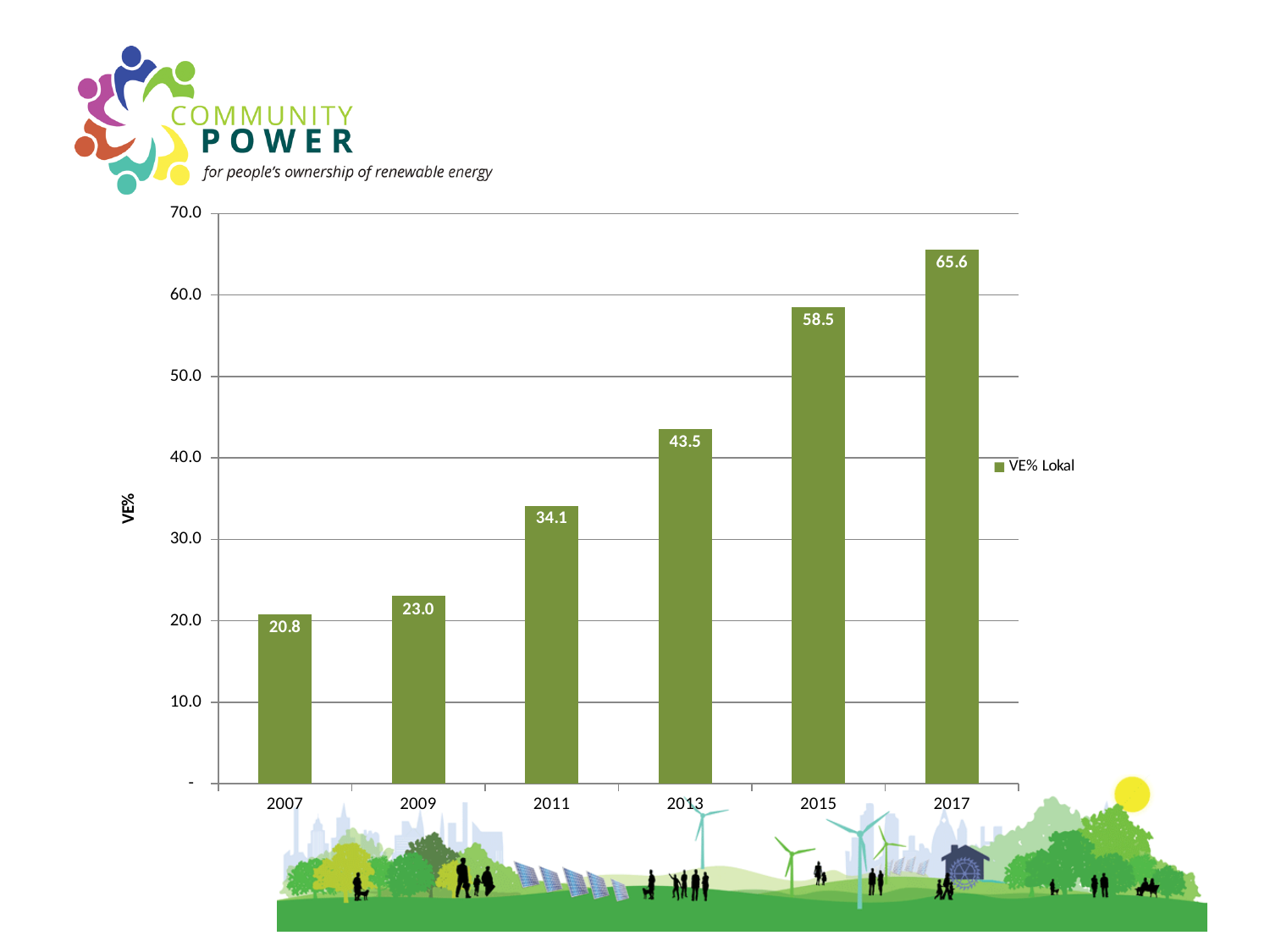
What is the difference between the VE% Lokal values for 2015 and 2013? 15.0 What is the VE% Lokal value for 2007? 20.8 How many series does the legend list? 1 Which year has the lowest VE% Lokal value? 2007 Which year has the highest VE% Lokal value? 2017 What is the VE% Lokal value for 2017? 65.6 Which is larger, the VE% Lokal value for 2011 or for 2009? 2011 What is the difference between the VE% Lokal values for 2017 and 2007? 44.8 How many years are shown on the x axis? 6 Do the VE% Lokal values rise or fall from 2007 to 2017? Rise What is the VE% Lokal value for 2013? 43.5 What kind of chart is shown on the slide? Bar chart